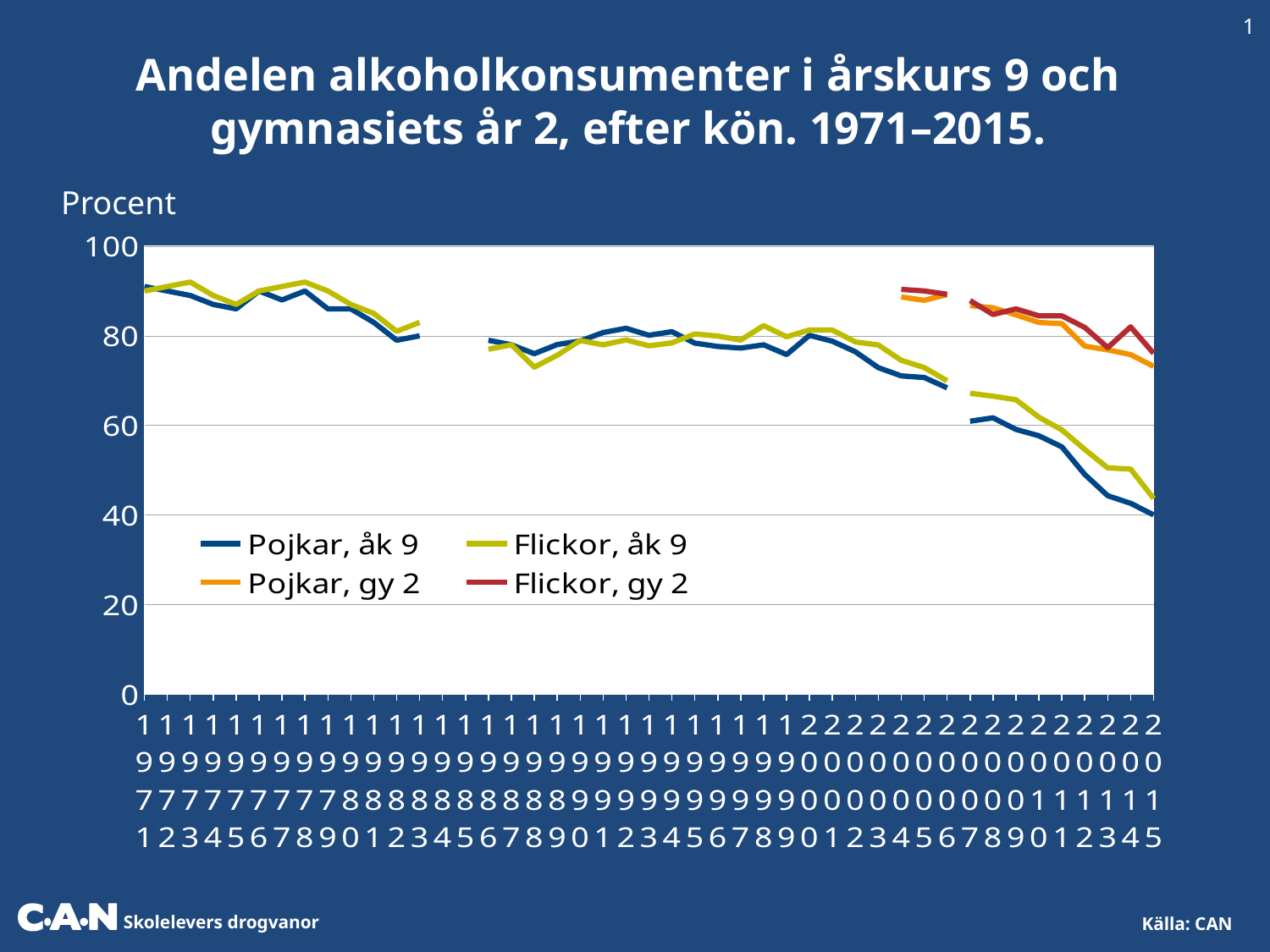
Is the value for 'Pojkar, åk 9' in 2015 greater or less than 60? less What kind of chart is shown on the slide? Line chart How many series does the legend list? 4 Is the value for 'Pojkar, åk 9' in 1971 greater or less than 80? greater In 2015, which is larger: the value for 'Flickor, gy 2' or the value for 'Pojkar, åk 9'? Flickor, gy 2 Does the value for 'Flickor, åk 9' rise or fall from 2000 to 2015? Fall What is the label on the vertical axis of the chart? Procent Which series has the lowest value in 2015? Pojkar, åk 9 Is the value for 'Pojkar, gy 2' in 2015 greater or less than 80? less Which colour is used for the 'Pojkar, åk 9' series? Blue Does the value for 'Pojkar, åk 9' rise or fall from 1971 to 2015? Fall